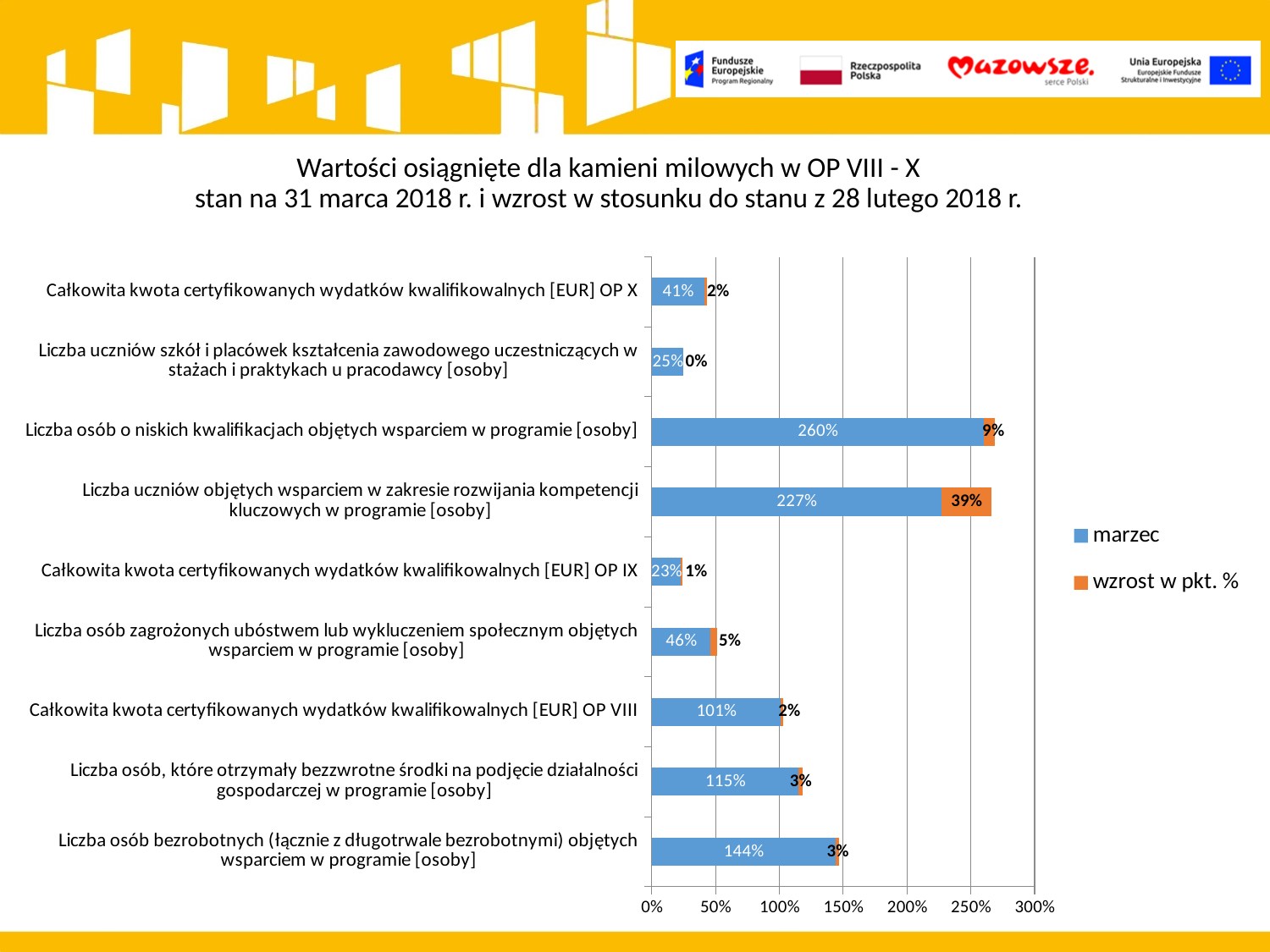
Which is larger: the 'marzec' value for 'Całkowita kwota certyfikowanych wydatków kwalifikowalnych [EUR] OP X' or for 'Liczba osób zagrożonych ubóstwem lub wykluczeniem społecznym objętych wsparciem w programie [osoby]'? Liczba osób zagrożonych ubóstwem lub wykluczeniem społecznym objętych wsparciem w programie [osoby] What is the 'marzec' value for 'Liczba osób o niskich kwalifikacjach objętych wsparciem w programie [osoby]'? 260% What is the 'wzrost w pkt. %' value for 'Liczba uczniów objętych wsparciem w zakresie rozwijania kompetencji kluczowych w programie [osoby]'? 39% What kind of chart is shown on the slide? Bar chart What is the 'marzec' value for 'Całkowita kwota certyfikowanych wydatków kwalifikowalnych [EUR] OP VIII'? 101% How many categories are shown on the chart? 9 Which category has the lowest 'marzec' value? Całkowita kwota certyfikowanych wydatków kwalifikowalnych [EUR] OP IX How many series does the legend list? 2 What is the difference between the 'marzec' values for 'Liczba osób bezrobotnych (łącznie z długotrwale bezrobotnymi) objętych wsparciem w programie [osoby]' and 'Liczba osób, które otrzymały bezzwrotne środki na podjęcie działalności gospodarczej w programie [osoby]'? 29% Which category has the highest 'wzrost w pkt. %' value? Liczba uczniów objętych wsparciem w zakresie rozwijania kompetencji kluczowych w programie [osoby] What is the total of the stacked bar for 'Liczba uczniów objętych wsparciem w zakresie rozwijania kompetencji kluczowych w programie [osoby]'? 266% Which category has the highest 'marzec' value? Liczba osób o niskich kwalifikacjach objętych wsparciem w programie [osoby]